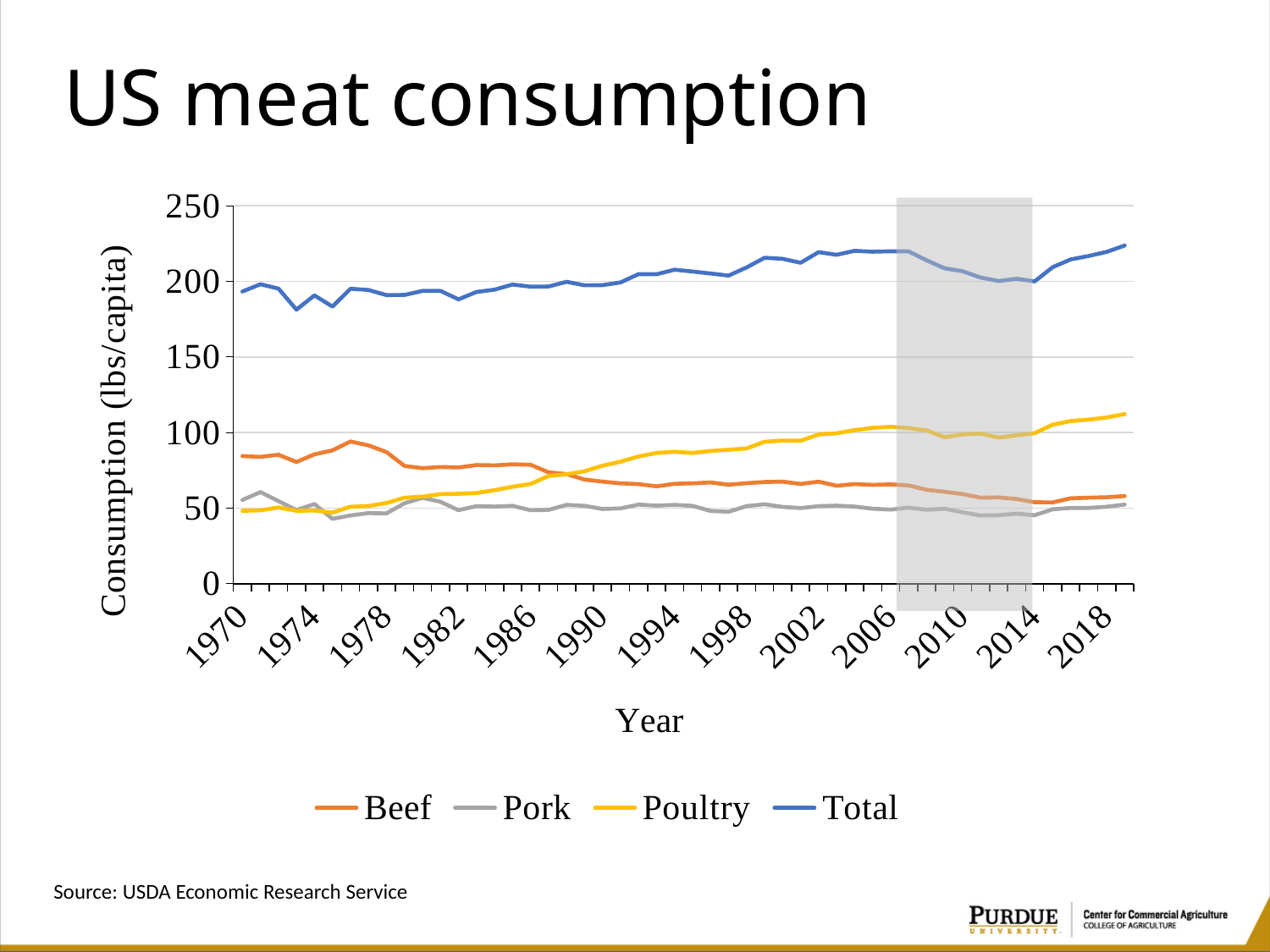
Does the Beef line rise or fall from 1976 to 2014? fall Is the value for Total in 2018 greater or less than 200? greater Which series has the highest values throughout the chart? Total Is the value for Beef in 1970 greater or less than 100? less What colour is the Total line? blue What kind of chart is shown on the slide? line chart In 1970, which is larger, Beef or Poultry? Beef Is the value for Poultry in 2018 greater or less than 100? greater What is the label on the y axis? Consumption (lbs/capita) How many series does the legend list? 4 Does the Poultry line rise or fall from 1970 to 2018? rise In 2018, which is larger, Beef or Poultry? Poultry